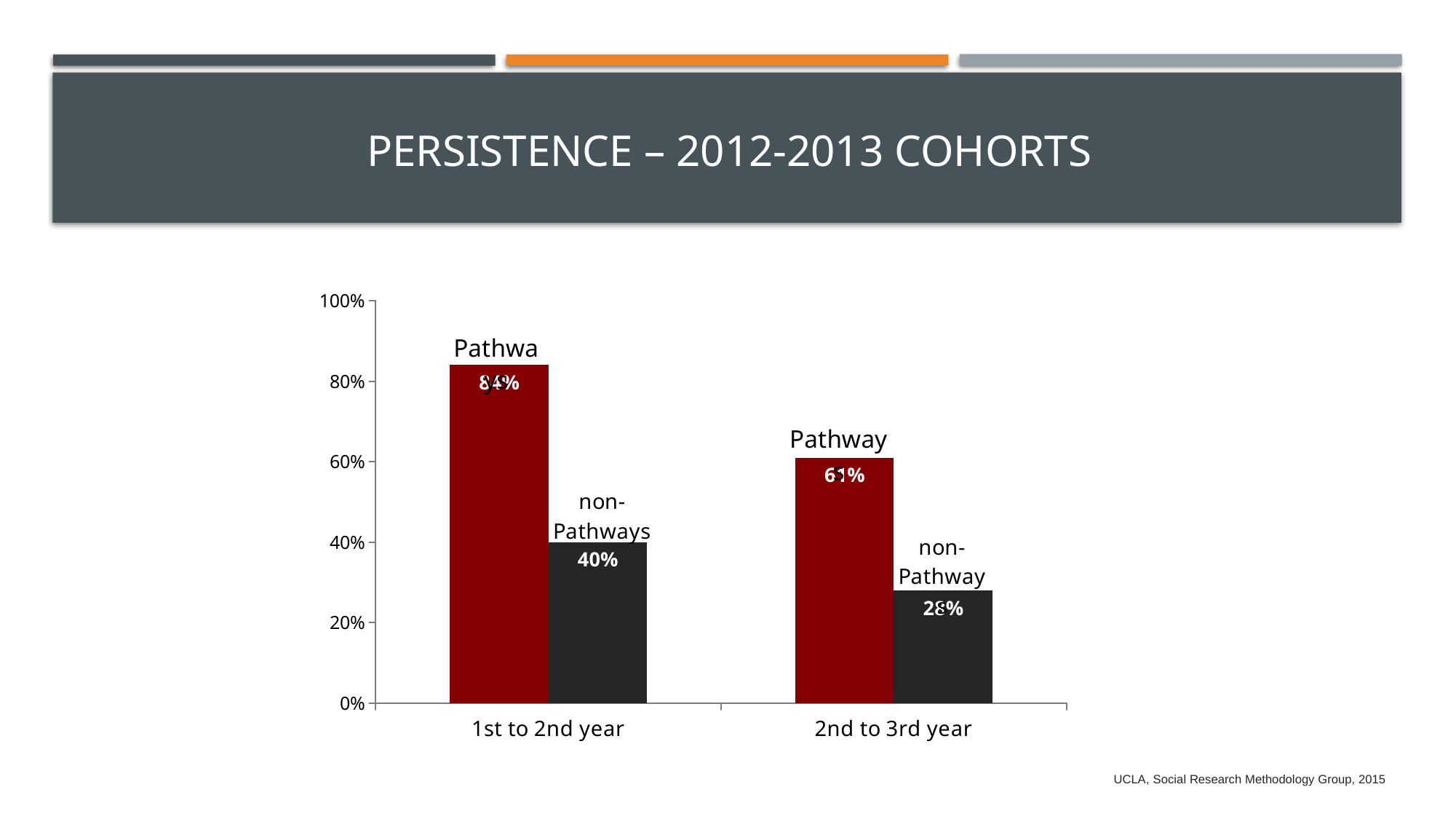
Which bar is the lowest on the chart? non-Pathway, 2nd to 3rd year Is the value for Pathway in the 1st to 2nd year category greater or less than 80%? greater In the 2nd to 3rd year category, which is larger: Pathway or non-Pathway? Pathway Do the Pathway values rise or fall from 1st to 2nd year to 2nd to 3rd year? Fall Which is larger: Pathway in 1st to 2nd year or Pathway in 2nd to 3rd year? Pathway in 1st to 2nd year What kind of chart is shown on the slide? Bar chart Which bar is the highest on the chart? Pathway, 1st to 2nd year How many categories are shown on the x axis? 2 What is the title of the slide? PERSISTENCE – 2012-2013 COHORTS Is the value for non-Pathway in the 2nd to 3rd year category greater or less than 40%? less What is the value for non-Pathways in the 1st to 2nd year category? 40%